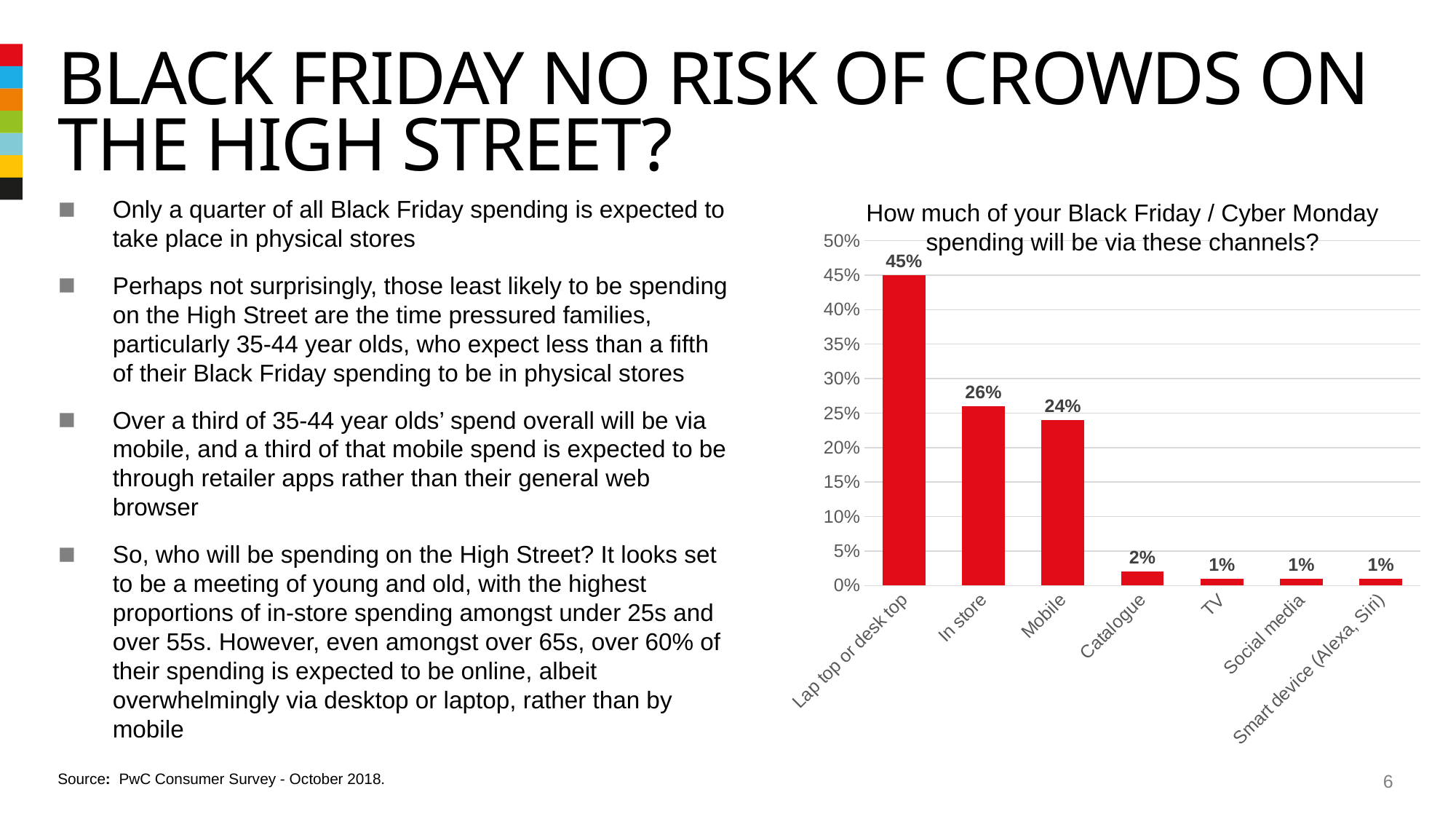
What is the difference between the Lap top or desk top and In store values? 19% What is the value shown for Catalogue? 2% Which is larger, the value for In store or the value for Mobile? In store What type of chart is shown on the slide? Bar chart What is the difference between the In store and Mobile values? 2% How many channels (categories) are shown on the x axis? 7 What percentage of Black Friday / Cyber Monday spending is expected via laptop or desktop? 45% What is the value shown for Mobile? 24% What is the value shown for In store? 26% Which channel has the highest share of spending? Lap top or desk top What value is shown for Social media? 1% What is the title of the chart? How much of your Black Friday / Cyber Monday spending will be via these channels?